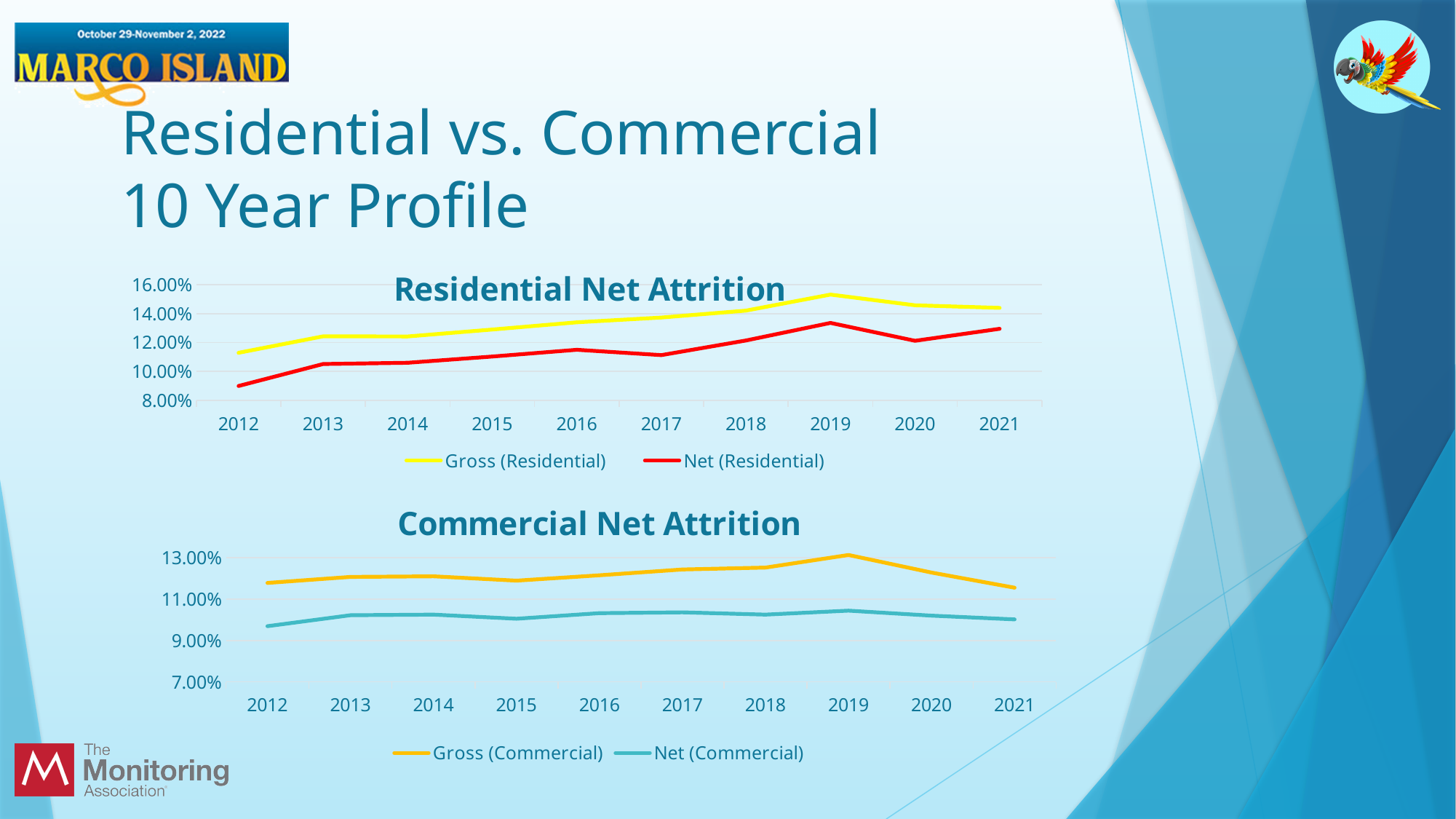
What kind of chart is the Residential Net Attrition chart? line chart In the Commercial Net Attrition chart, is the Net (Commercial) value for 2012 greater or less than 11.00%? less In the Residential Net Attrition chart, is the Gross (Residential) value for 2019 greater or less than 14.00%? greater How many series does the legend of the Commercial Net Attrition chart list? 2 In the Commercial Net Attrition chart, does the Gross (Commercial) line rise or fall from 2019 to 2021? fall How many years are shown on the x axis of the Residential Net Attrition chart? 10 In the Commercial Net Attrition chart, which year has the highest Gross (Commercial) value? 2019 In the Residential Net Attrition chart, which year has the highest Gross (Residential) value? 2019 In the Residential Net Attrition chart, is the Net (Residential) value for 2012 greater or less than 10.00%? less In the Commercial Net Attrition chart, which is larger in 2021, Gross (Commercial) or Net (Commercial)? Gross (Commercial) What colour is the Net (Residential) line in the Residential Net Attrition chart? red In the Residential Net Attrition chart, which year has the lowest Net (Residential) value? 2012